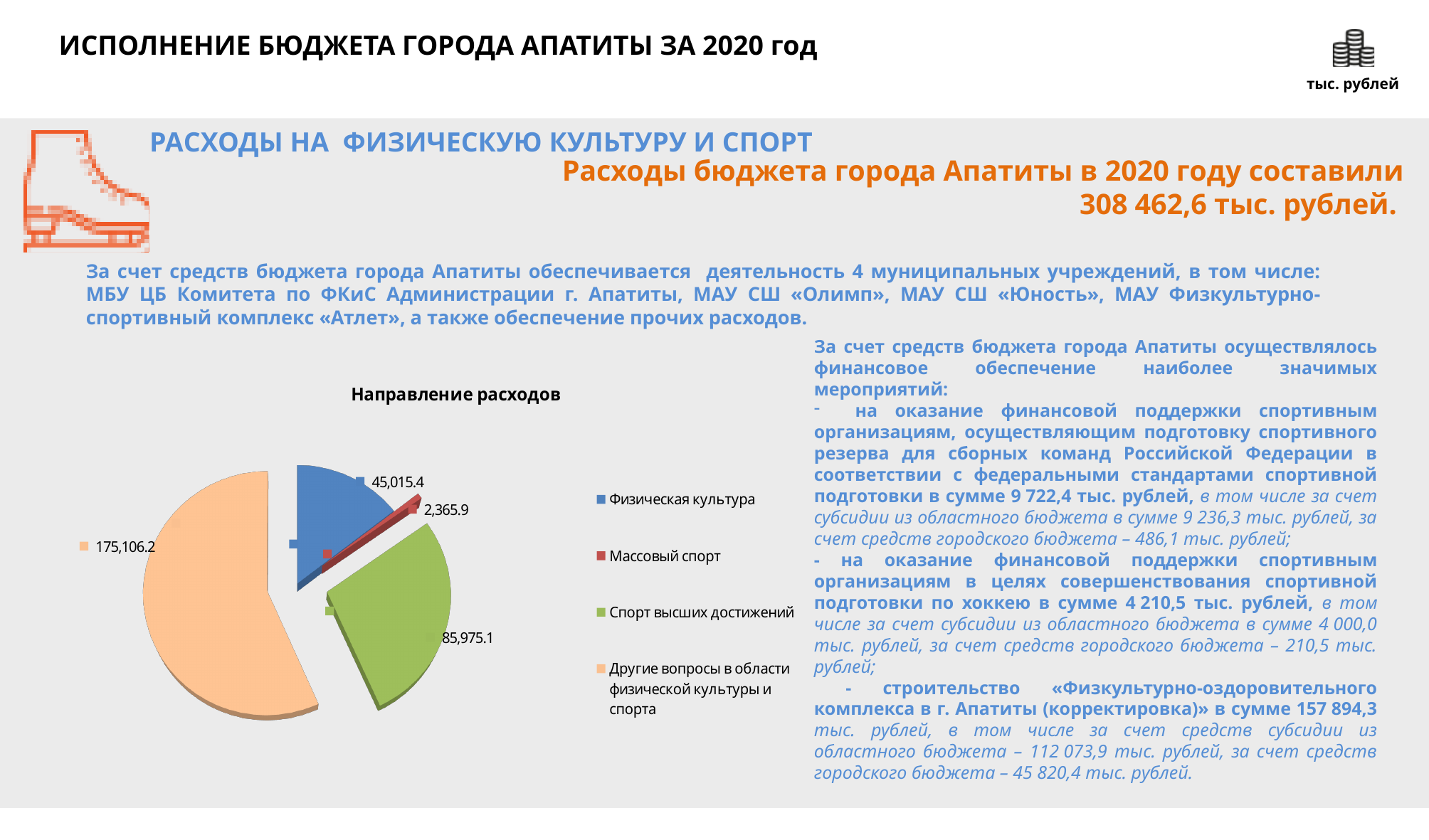
What is the difference between «Спорт высших достижений» and «Физическая культура» in the pie chart? 40,959.7 What is the value for «Физическая культура» in the pie chart? 45,015.4 What is the value for «Массовый спорт» in the pie chart? 2,365.9 What is the value for «Спорт высших достижений» in the pie chart? 85,975.1 Which category has the smallest slice in the pie chart? Массовый спорт Which category has the largest slice in the pie chart? Другие вопросы в области физической культуры и спорта What is the difference between «Другие вопросы в области физической культуры и спорта» and «Спорт высших достижений» in the pie chart? 89,131.1 Which is larger in the pie chart: «Спорт высших достижений» or «Физическая культура»? Спорт высших достижений What is the value for «Другие вопросы в области физической культуры и спорта» in the pie chart? 175,106.2 What type of chart is shown under the title «Направление расходов»? Pie chart How many categories does the pie chart show? 4 What colour is the slice for «Спорт высших достижений» in the pie chart? Green